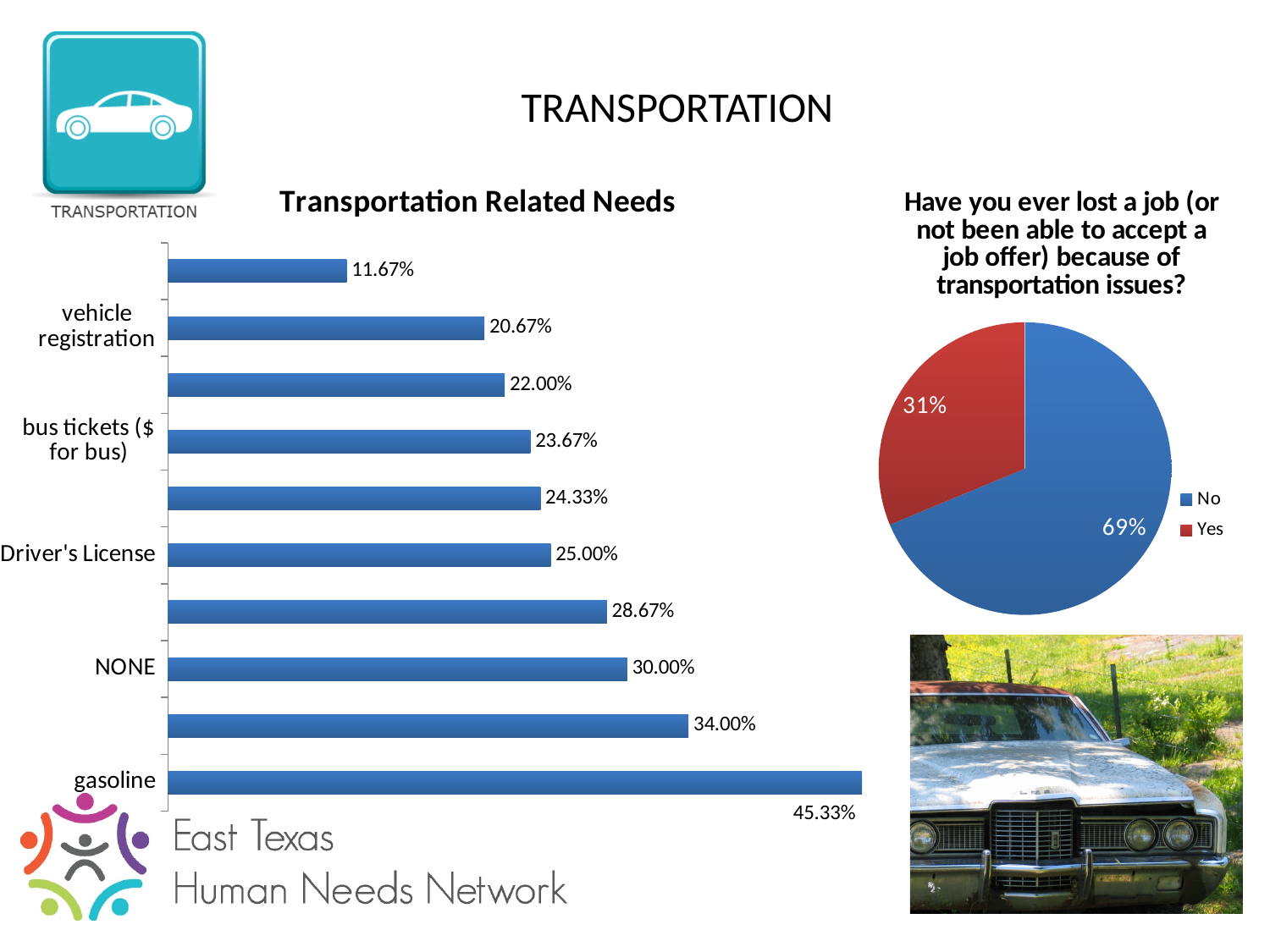
In the Transportation Related Needs chart, what is the value for gasoline? 45.33% In the Transportation Related Needs chart, which labelled category has the highest value? gasoline In the Transportation Related Needs chart, what is the value for bus tickets ($ for bus)? 23.67% How many bars are plotted in the Transportation Related Needs chart? 10 In the Transportation Related Needs chart, what is the value for vehicle registration? 20.67% In the Transportation Related Needs chart, what is the value for Driver's License? 25.00% In the pie chart about losing a job because of transportation issues, which answer has the larger share? No What kind of chart is the Transportation Related Needs chart? bar chart In the Transportation Related Needs chart, what is the value for NONE? 30.00% In the pie chart about losing a job because of transportation issues, what share of respondents answered Yes? 31% In the Transportation Related Needs chart, what is the difference between the values for gasoline and NONE? 15.33% In the Transportation Related Needs chart, which is larger, the value for Driver's License or the value for vehicle registration? Driver's License